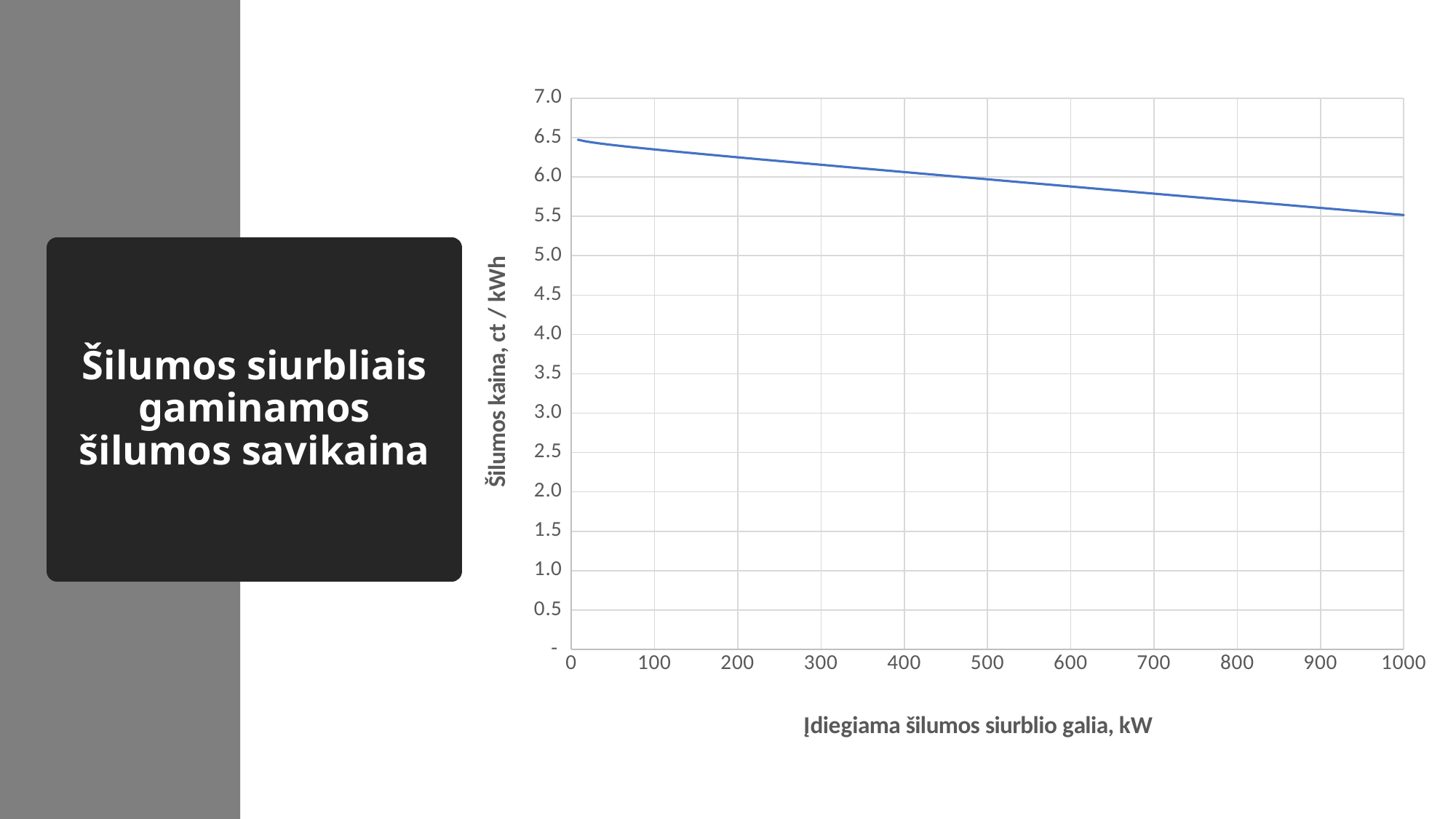
Is the heat price at 200 kW greater or less than 6.0 ct/kWh? greater What is the label of the vertical axis of the chart? Šilumos kaina, ct / kWh Is the heat price at 1000 kW greater or less than 5.0 ct/kWh? greater Is the heat price at 1000 kW greater or less than 6.0 ct/kWh? less What kind of chart is shown on the slide? line chart Which has the higher heat price: an installed capacity of 0 kW or 1000 kW? 0 kW Does the heat price (Šilumos kaina) rise or fall as the installed heat pump capacity increases from 0 to 1000 kW? fall What is the label of the horizontal axis of the chart? Įdiegiama šilumos siurblio galia, kW